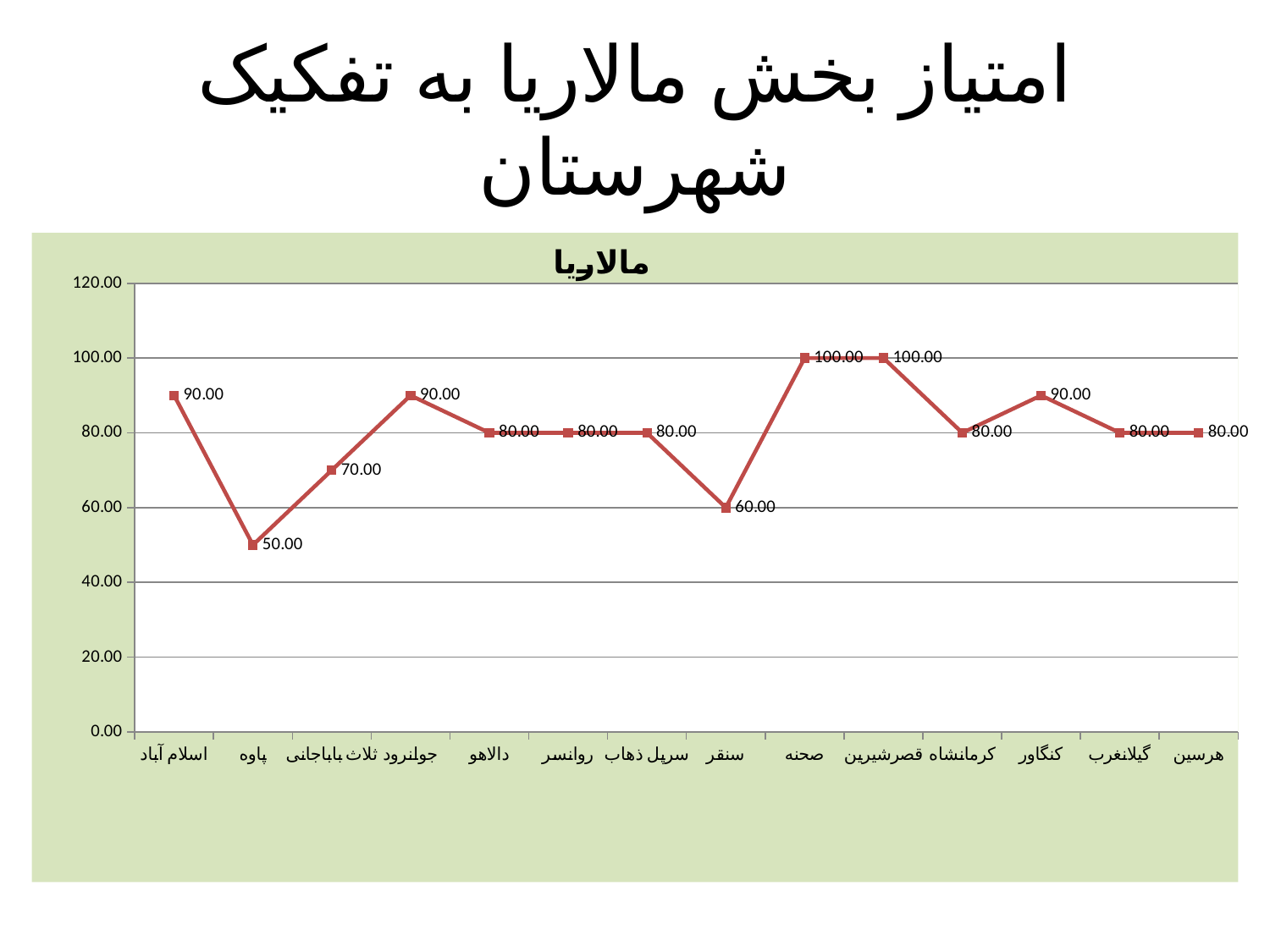
What is the value for سنقر? 60.00 What kind of chart is shown? line chart How many categories are plotted on the x axis? 14 What is the value for ثلاث باباجانی? 70.00 Which categories share the highest value of 100.00? صحنه and قصرشیرین Which category has the lowest value? پاوه What is the value for پاوه? 50.00 Which is larger, the value for اسلام آباد or the value for پاوه? اسلام آباد What is the title shown inside the chart area? مالاریا Is the value for کرمانشاه greater or less than 100.00? less What is the difference between the values for صحنه and سنقر? 40.00 What is the value for کنگاور? 90.00